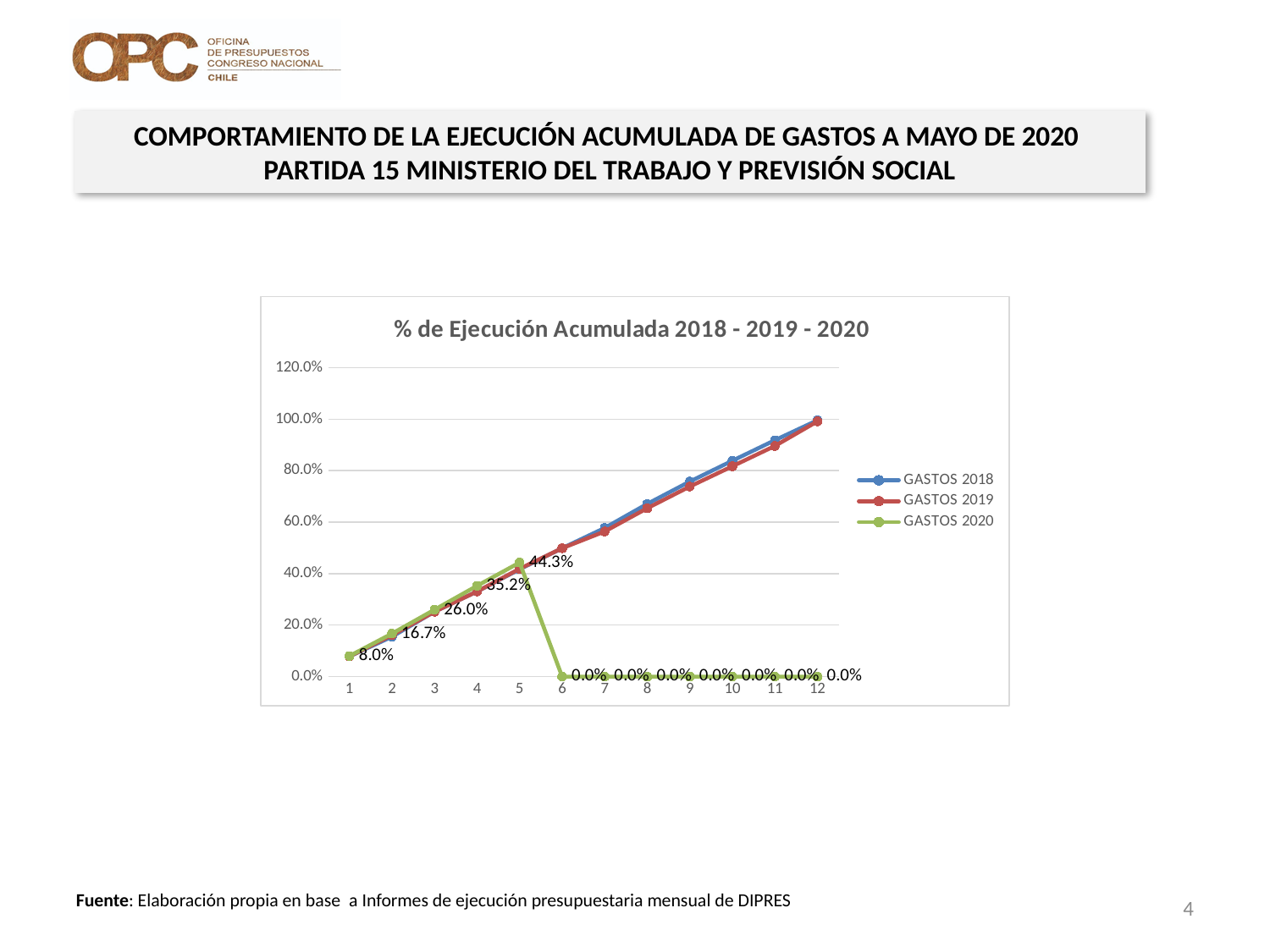
What kind of chart is shown? line chart What is the value for GASTOS 2020 at month 8? 0.0% Do the GASTOS 2019 values rise or fall from month 1 to month 12? rise What is the value for GASTOS 2020 at month 5? 44.3% What is the value for GASTOS 2020 at month 3? 26.0% What is the value for GASTOS 2020 at month 1? 8.0% Which is larger for GASTOS 2020: the value at month 2 or the value at month 4? month 4 What is the difference between the GASTOS 2020 values at month 5 and month 4? 9.1% How many series does the legend list? 3 Is the value for GASTOS 2018 at month 12 greater or less than 80.0%? greater How many months are shown on the x axis? 12 At which month does GASTOS 2020 reach its highest value? 5